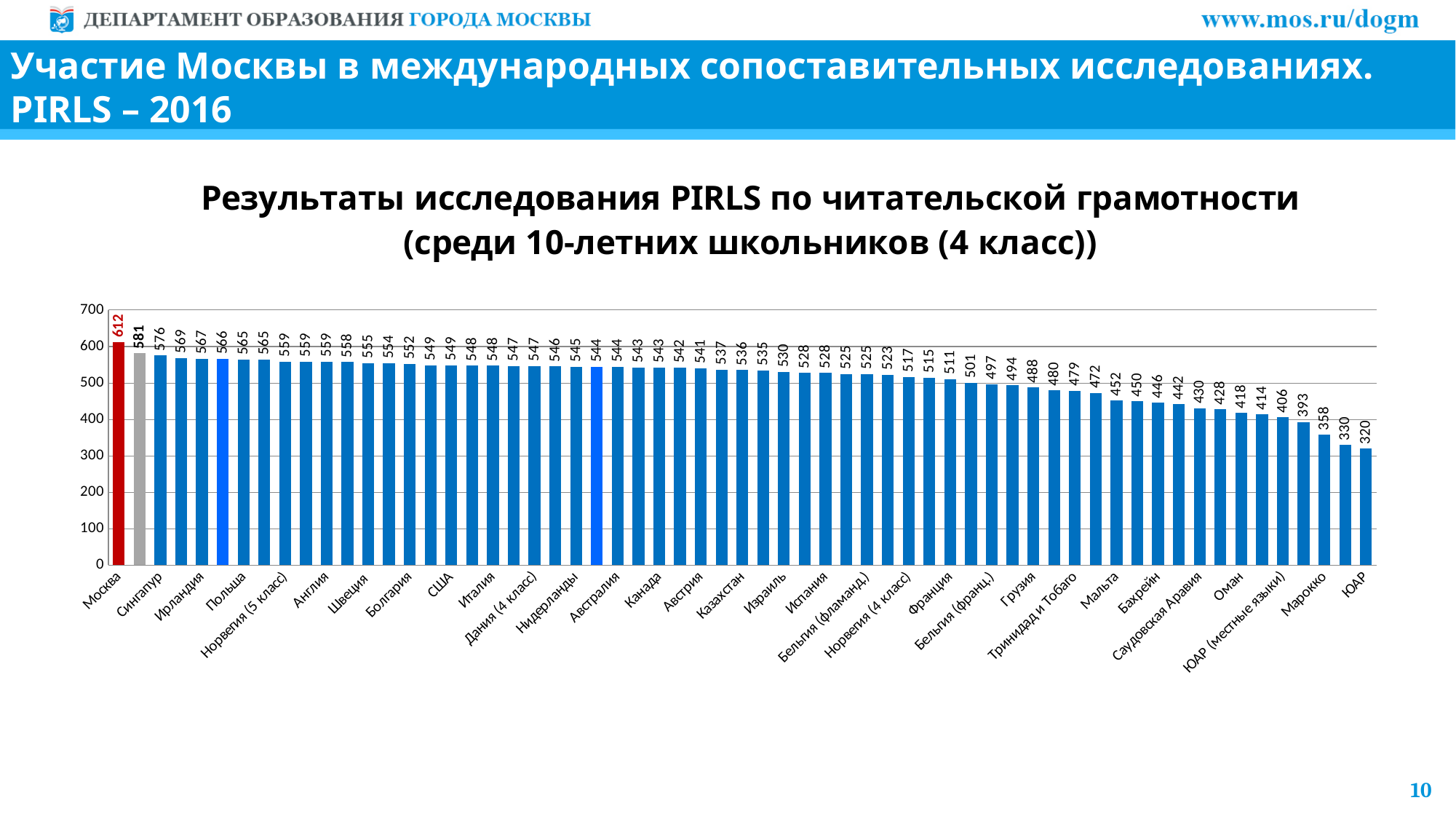
Which has a larger value, Москва or Сингапур? Москва Which category has the lowest value on the chart? ЮАР What is the value shown for Англия? 559 What is the difference between the values for Москва and ЮАР? 292 Is the value for Марокко greater or less than 400? less What colour is the bar for Москва? red What is the value shown for ЮАР? 320 What is the value shown for Австралия? 544 What kind of chart is shown on the slide? bar chart What is the value shown for Москва? 612 What is the value shown for Италия? 548 Which category has the highest value on the chart? Москва